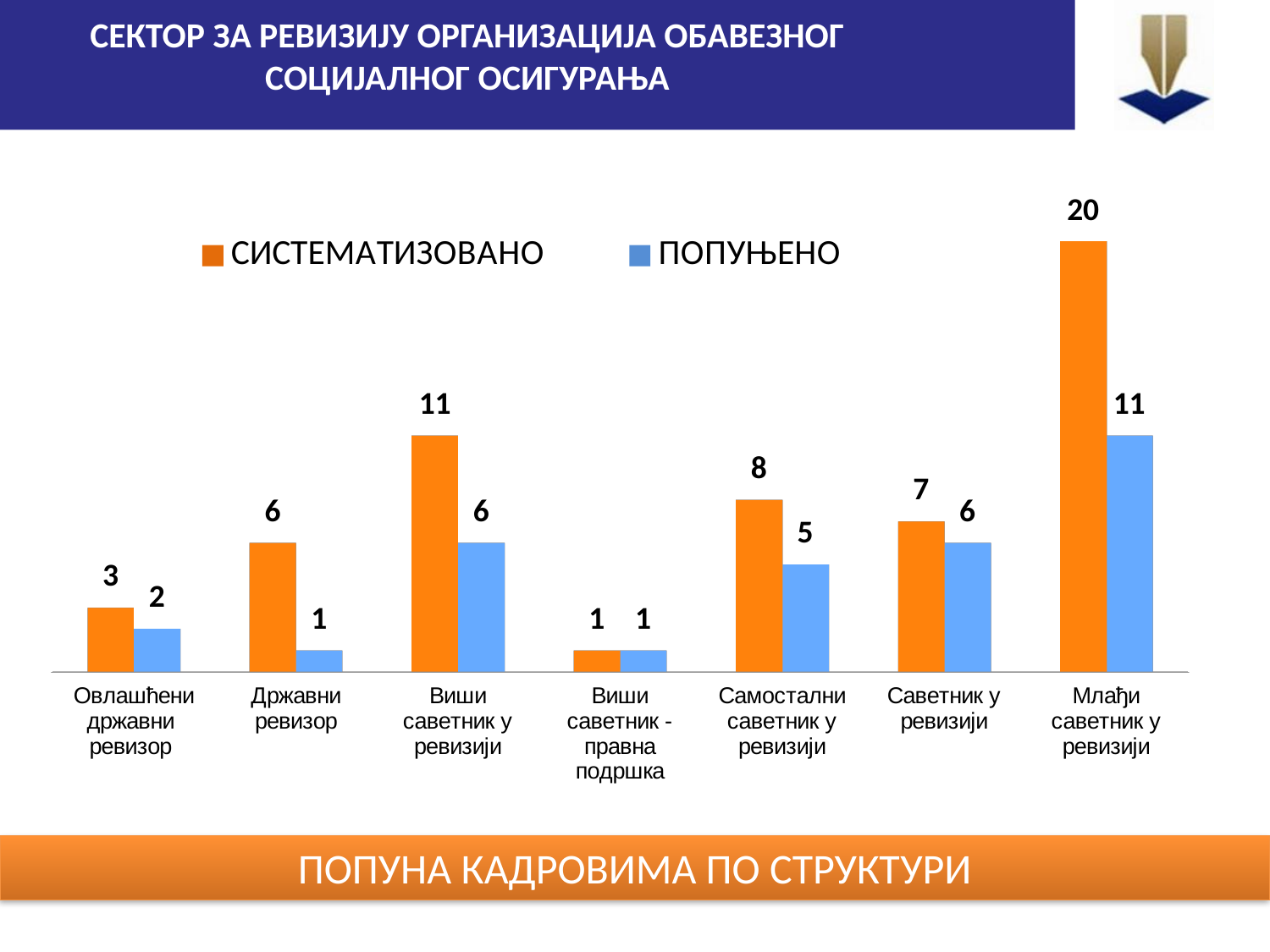
What is the ПОПУЊЕНО value for Државни ревизор? 1 What is the ПОПУЊЕНО value for Самостални саветник у ревизији? 5 What is the difference between the СИСТЕМАТИЗОВАНО and ПОПУЊЕНО values for Млађи саветник у ревизији? 9 How many series does the legend list? 2 Which is larger: the ПОПУЊЕНО value for Саветник у ревизији or the ПОПУЊЕНО value for Самостални саветник у ревизији? Саветник у ревизији What is the difference between the СИСТЕМАТИЗОВАНО and ПОПУЊЕНО values for Виши саветник у ревизији? 5 How many categories are shown on the x axis? 7 Which colour represents the ПОПУЊЕНО series? Blue Which category has the lowest СИСТЕМАТИЗОВАНО value? Виши саветник - правна подршка What is the СИСТЕМАТИЗОВАНО value for Млађи саветник у ревизији? 20 What kind of chart is shown on the slide? Bar chart Which category has the highest СИСТЕМАТИЗОВАНО value? Млађи саветник у ревизији